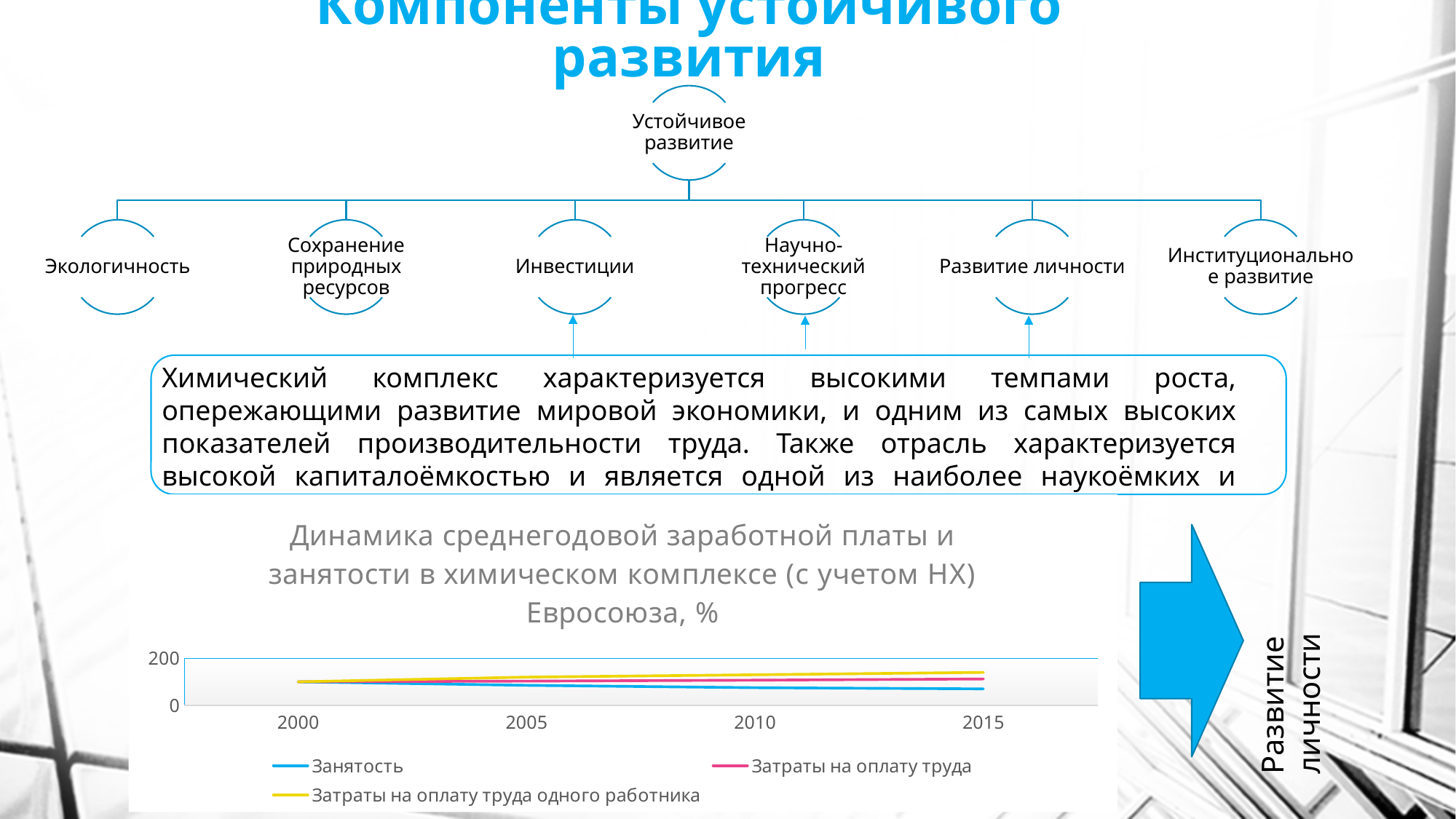
What kind of chart is shown at the bottom of the slide? line chart Is the value for Занятость in 2015 greater or less than 200? less What is the first year shown on the x axis of the chart? 2000 Does the value for Затраты на оплату труда одного работника rise or fall from 2000 to 2015? rise Which series has the highest value in 2015? Затраты на оплату труда одного работника Which colour is used for the Занятость series in the chart? blue How many series does the legend of the chart list? 3 In 2015, which is larger: Занятость or Затраты на оплату труда одного работника? Затраты на оплату труда одного работника How many years are labelled on the x axis of the chart? 4 Does the value for Занятость rise or fall from 2000 to 2015? fall Is the value for Затраты на оплату труда одного работника in 2015 greater or less than 200? less Which series has the lowest value in 2015? Занятость